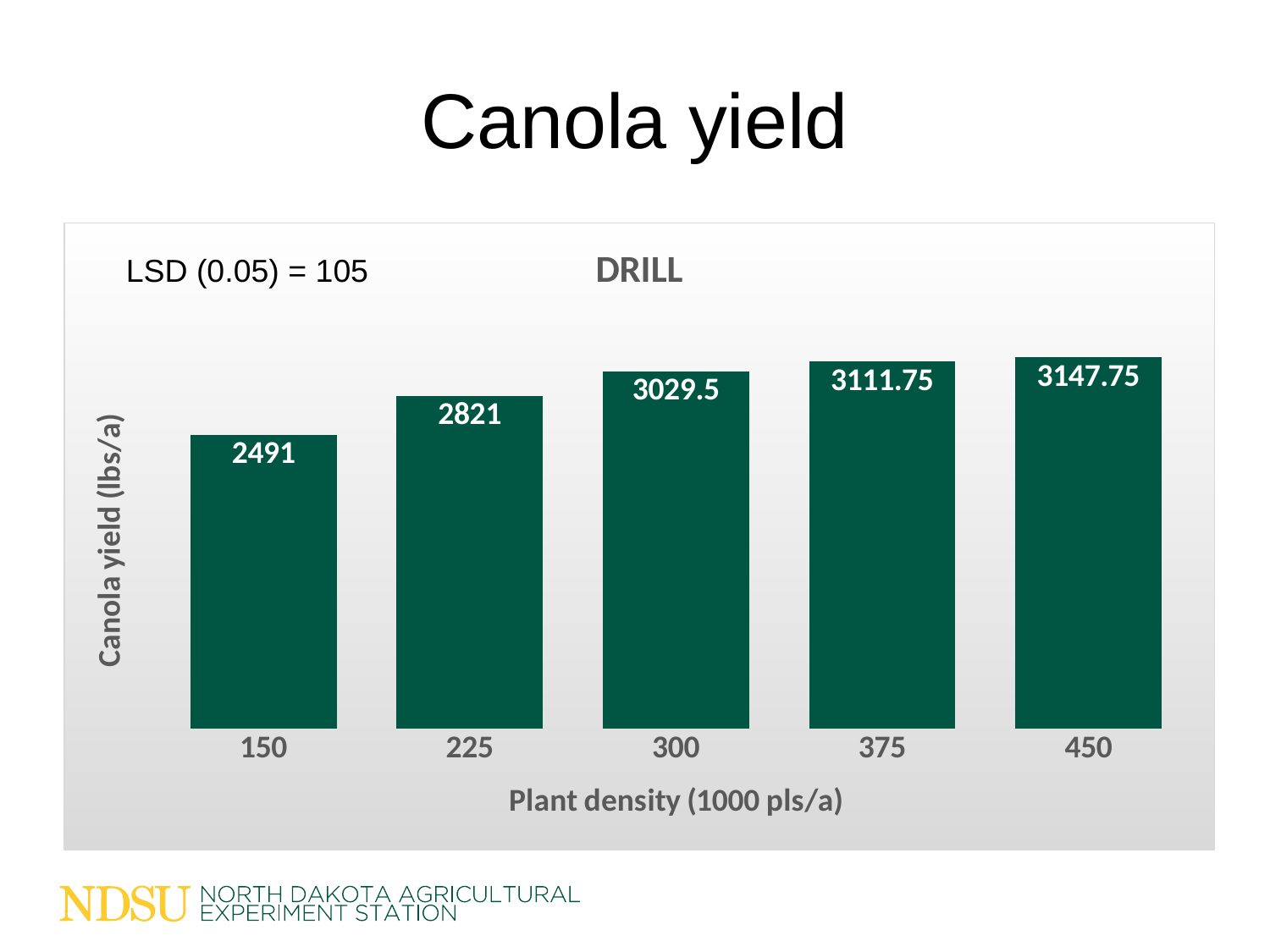
What is the difference in canola yield between plant densities 450 and 375? 36 What is the canola yield at a plant density of 450 (1000 pls/a)? 3147.75 Which plant density has the lowest canola yield? 150 What is the difference in canola yield between plant densities 225 and 150? 330 What kind of chart is shown on the slide? Bar chart How many plant density categories are shown in the chart? 5 Does canola yield rise or fall as plant density increases along the x axis? Rise What is the canola yield at a plant density of 150 (1000 pls/a)? 2491 Which has a higher canola yield, plant density 225 or plant density 300? 300 What is the LSD (0.05) value shown on the chart? 105 Which plant density has the highest canola yield? 450 What is the canola yield at a plant density of 300 (1000 pls/a)? 3029.5